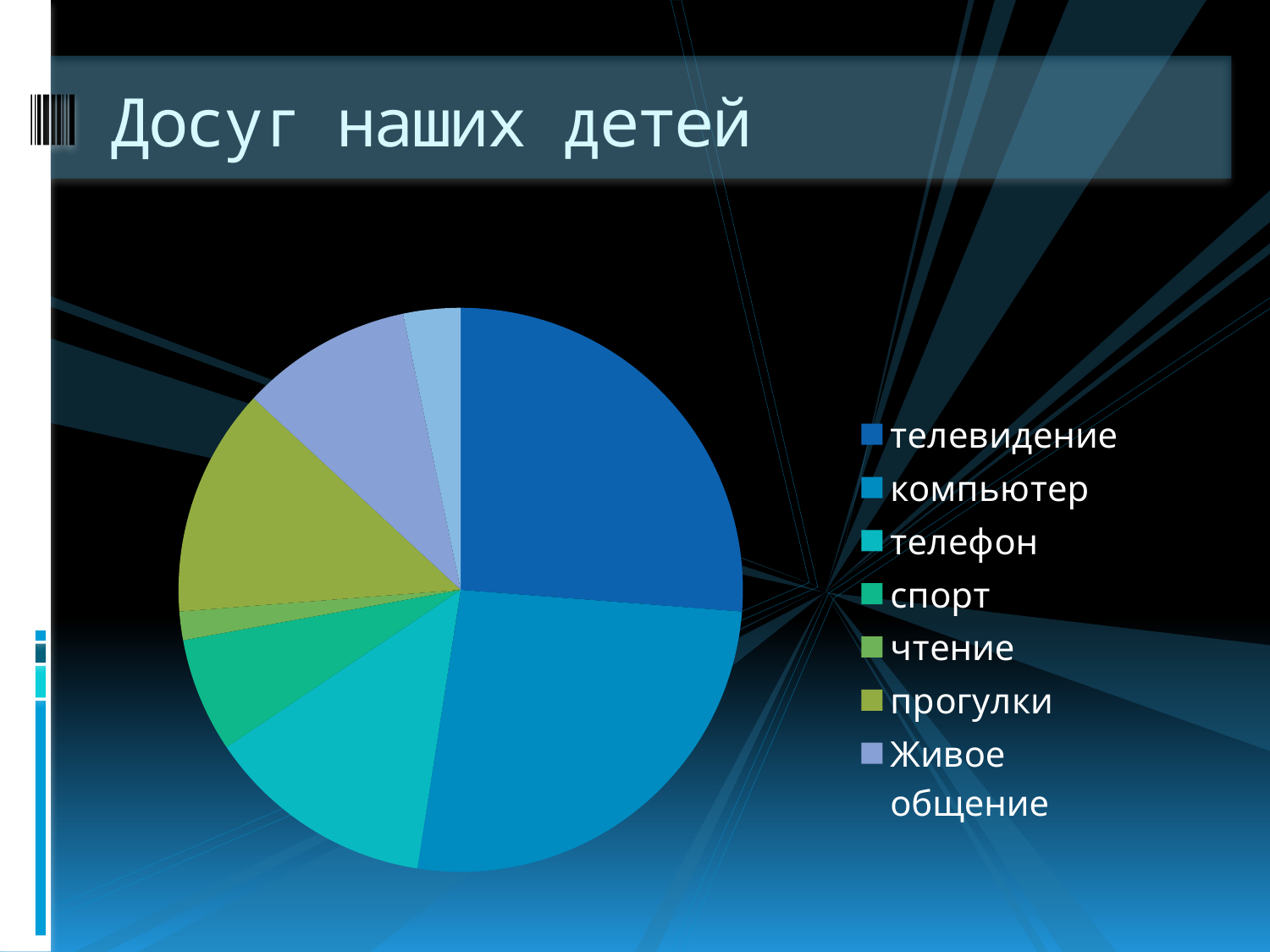
Which slice is larger, телевидение or спорт? телевидение Which category has the smallest slice of the pie? чтение Which slice is larger, прогулки or чтение? прогулки Which legend entry is listed first in the pie chart's legend? телевидение Which slice is larger, компьютер or телефон? компьютер How many entries does the legend of the pie chart list? 7 What kind of chart is shown on the slide? pie chart What is the title of the slide with the pie chart? Досуг наших детей